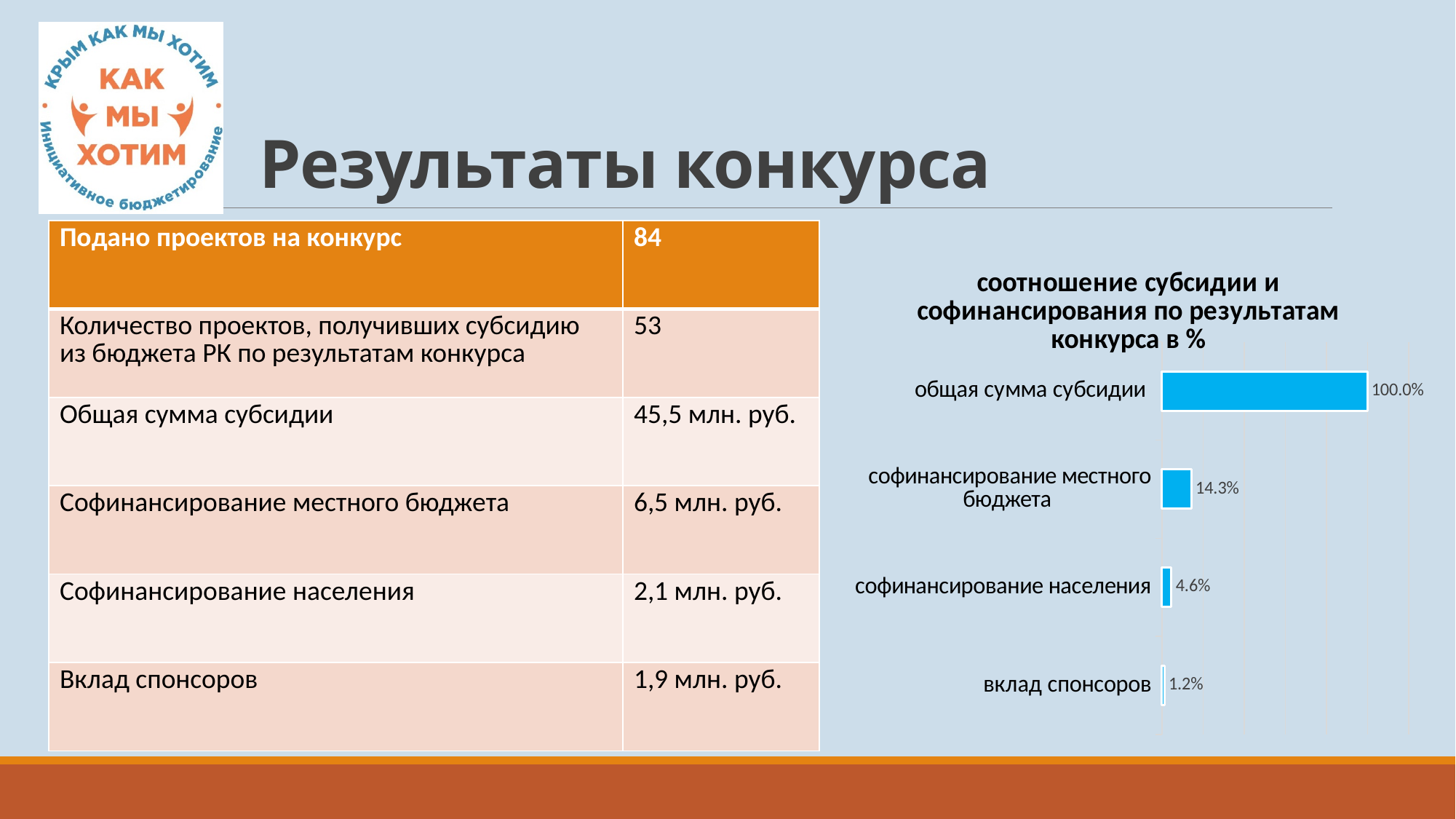
What is the value for вклад спонсоров in the chart? 1.2% What is the difference between the values for софинансирование местного бюджета and софинансирование населения? 9.7% What is the title of the chart? соотношение субсидии и софинансирования по результатам конкурса в % What is the value for софинансирование местного бюджета in the chart? 14.3% Which category has the highest value in the chart? общая сумма субсидии What type of chart is shown on the slide? bar chart What is the value for софинансирование населения in the chart? 4.6% Which is larger: the value for софинансирование населения or the value for вклад спонсоров? софинансирование населения How many categories are shown in the chart? 4 What is the value for общая сумма субсидии in the chart? 100.0% What colour are the bars in the chart? blue Which category has the lowest value in the chart? вклад спонсоров